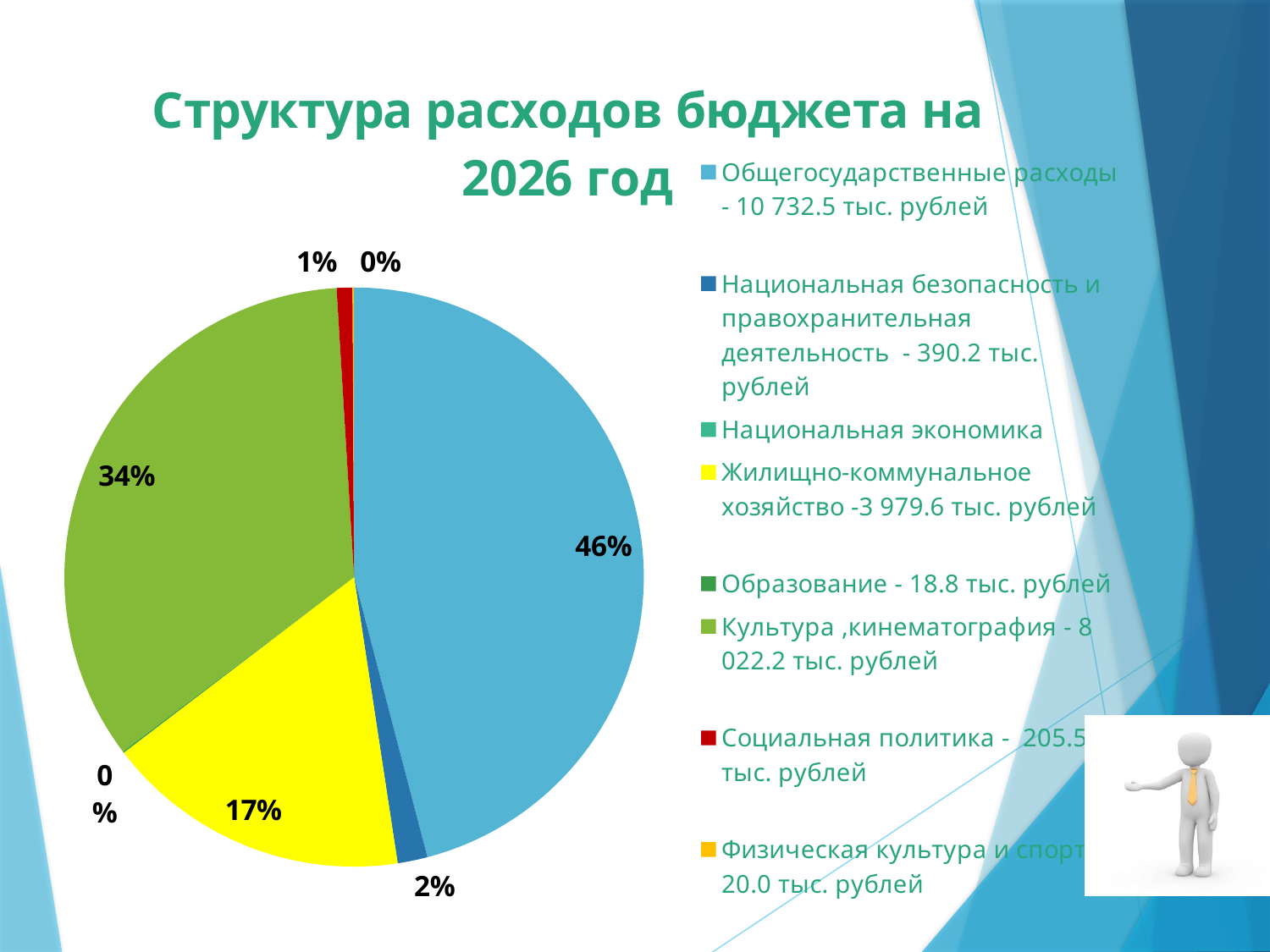
What kind of chart is shown on the slide? pie chart Which slice is larger: Культура, кинематография or Жилищно-коммунальное хозяйство? Культура, кинематография What share of the pie is Социальная политика? 1% How many entries does the legend list? 8 What share of the pie is Жилищно-коммунальное хозяйство? 17% What is the difference in percentage points between the Общегосударственные расходы slice and the Культура, кинематография slice? 12% What is the title of the chart? Структура расходов бюджета на 2026 год Which category has the largest slice of the pie? Общегосударственные расходы What share of the pie is Общегосударственные расходы? 46% According to the legend, what amount is given for Образование? 18.8 тыс. рублей